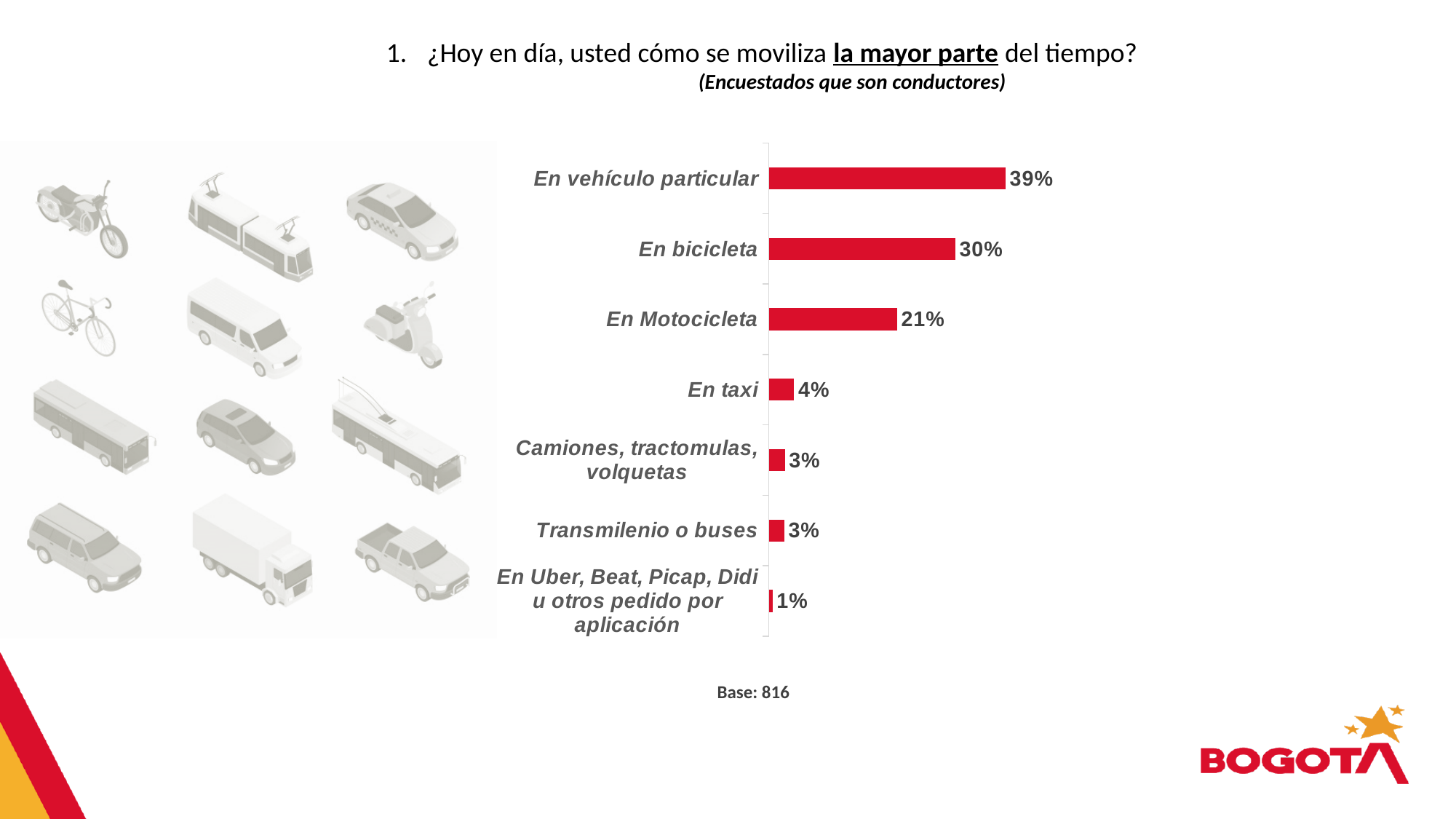
Which is larger, the value for En Motocicleta or the value for En taxi? En Motocicleta How many categories are shown in the chart? 7 What is the value for En Motocicleta? 21% Which category has the highest value? En vehículo particular What is the value for En Uber, Beat, Picap, Didi u otros pedido por aplicación? 1% What is the base (number of respondents) shown below the chart? 816 What kind of chart is shown on the slide? Bar chart What is the value for En taxi? 4% Which category has the lowest value? En Uber, Beat, Picap, Didi u otros pedido por aplicación What is the difference between the values for En vehículo particular and En bicicleta? 9% What is the value for En vehículo particular? 39% What is the value for En bicicleta? 30%